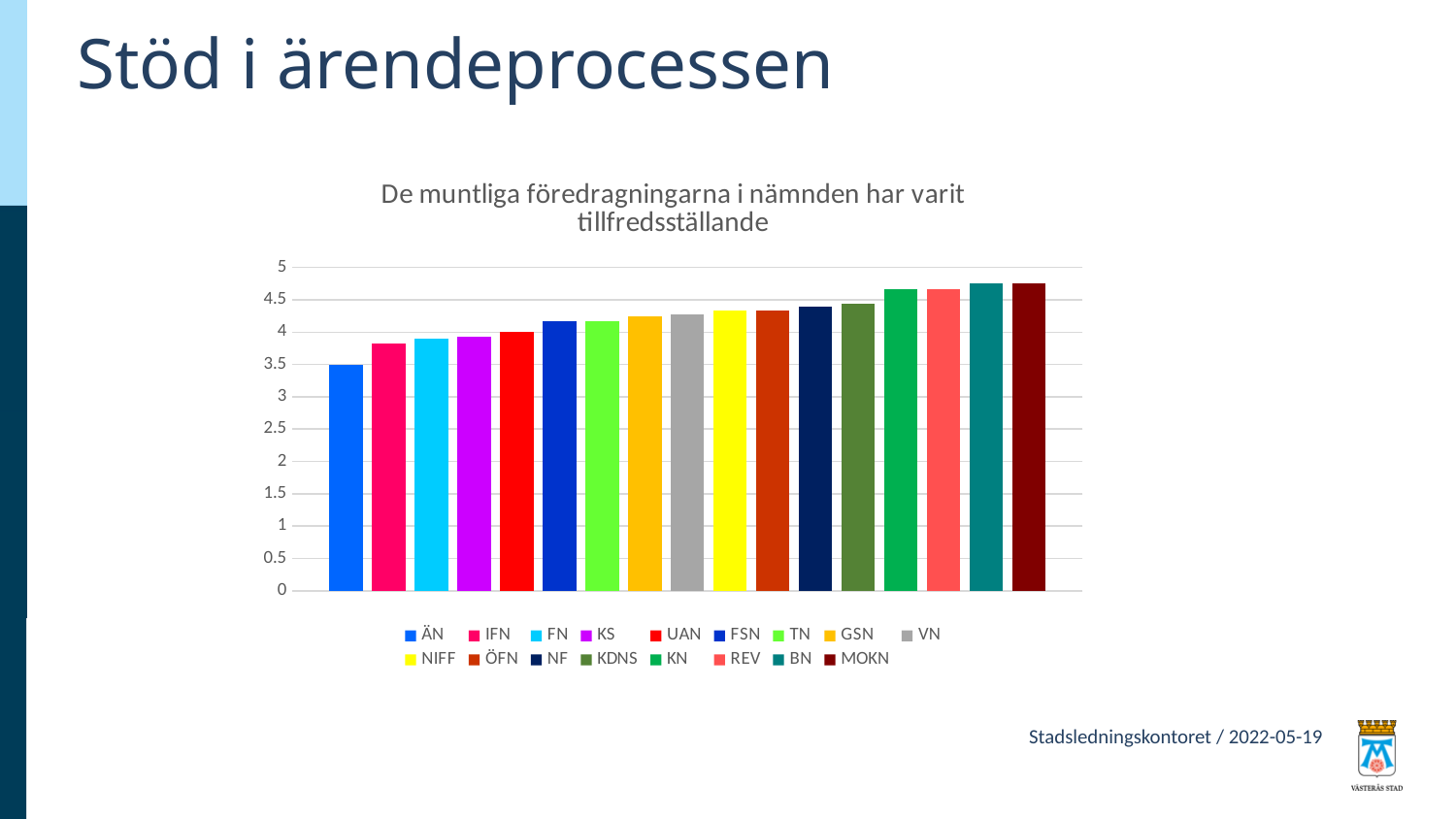
What is the title of the chart? De muntliga föredragningarna i nämnden har varit tillfredsställande Is the value for KN greater or less than 4.5? greater Which has the larger value, IFN or KN? KN Is the value for VN greater or less than 4? greater How many entries does the chart legend list? 17 Which has the larger value, FN or VN? VN What kind of chart is shown on the slide? Bar chart Is the value for NF greater or less than 4.5? less Do the bar values rise or fall from left to right across the chart? Rise Which category has the lowest value in the chart? ÄN How many bars are plotted in the chart? 17